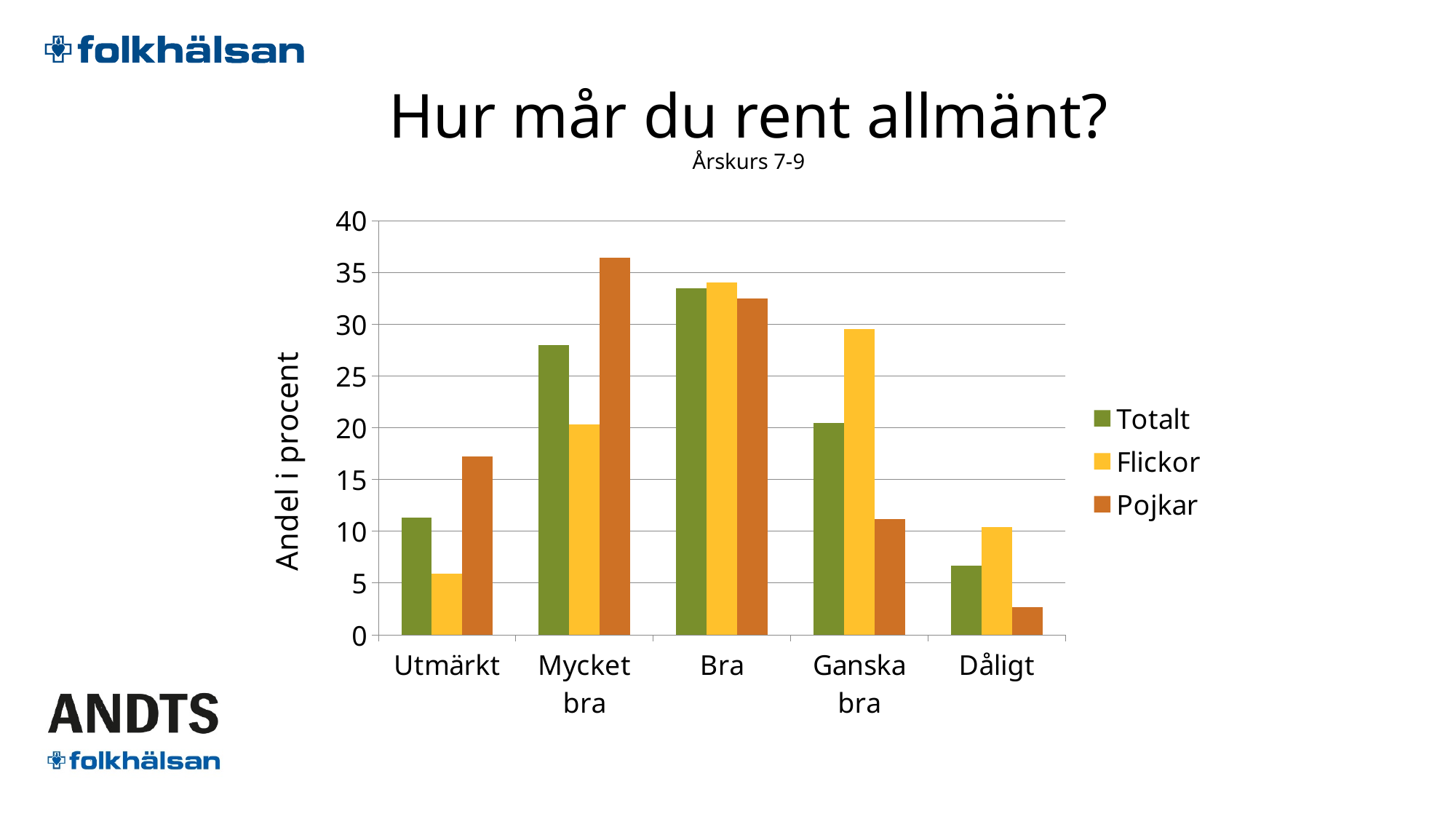
What kind of chart is shown on the slide? bar chart For Ganska bra, which is larger: Flickor or Pojkar? Flickor For which category is the Totalt value highest? Bra How many categories are shown on the x axis? 5 For which category is the Pojkar value highest? Mycket bra For Utmärkt, which is larger: Pojkar or Flickor? Pojkar For which category is the Pojkar value lowest? Dåligt What is the title of the y axis? Andel i procent Is the Flickor value for Utmärkt greater or less than 10? less Is the Pojkar value for Mycket bra greater or less than 30? greater How many series does the legend list? 3 For which category is the Flickor value lowest? Utmärkt